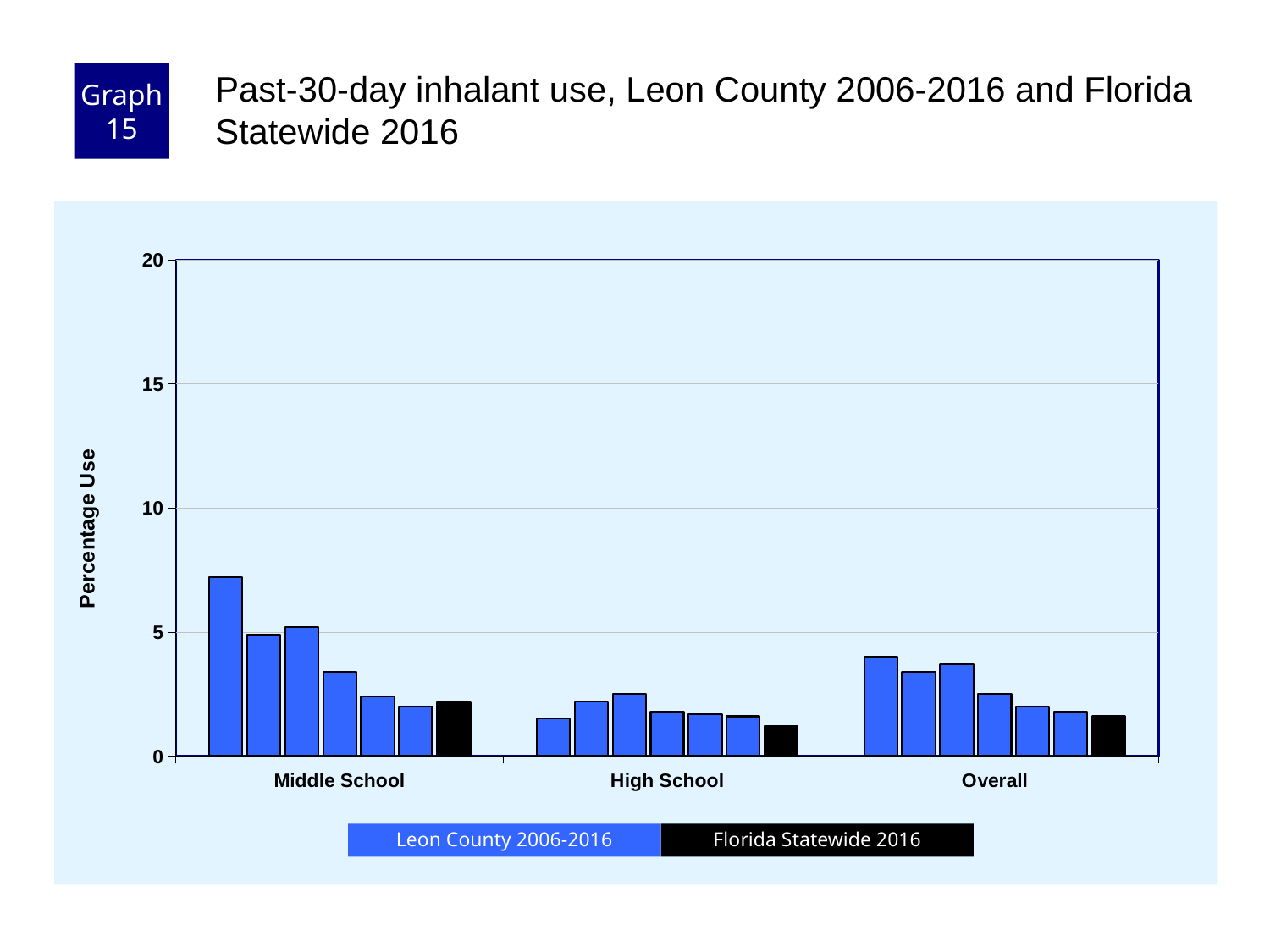
How many bars are plotted in the Middle School group? 7 How many series does the chart's legend list? 2 Which group has the lowest Florida Statewide 2016 bar? High School How many categories are shown on the x axis of the chart? 3 Is the Florida Statewide 2016 value for High School greater or less than 5? less What is the label on the chart's vertical axis? Percentage Use What kind of chart is shown on the slide? bar chart Which is larger, the Florida Statewide 2016 bar for Middle School or the Florida Statewide 2016 bar for High School? Middle School Is the value of the tallest Leon County bar in the Middle School group greater or less than 5? greater Which group contains the tallest bar in the chart? Middle School Do the Leon County 2006-2016 bars in the Middle School group generally rise or fall from left to right? fall Is the Florida Statewide 2016 value for Middle School greater or less than 5? less